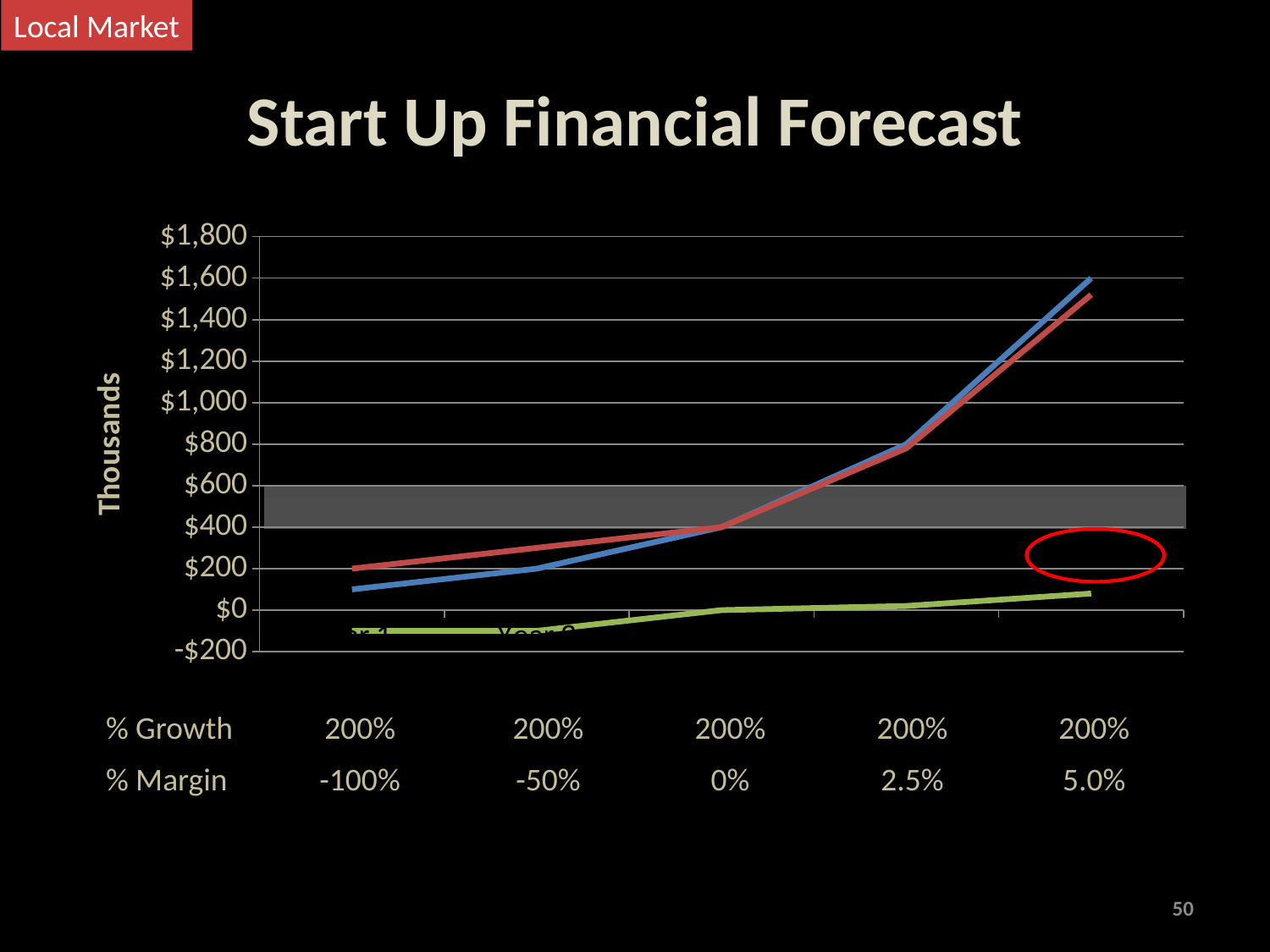
What is the title of the chart? Start Up Financial Forecast What is the highest value shown on the vertical axis? $1,800 In the table below the chart, what is the % Margin value in the last (fifth) column? 5.0% Is the final (rightmost) value of the blue line greater or less than $1,400? greater Is the first (leftmost) value of the green line greater or less than $0? less What kind of chart is shown on the slide? line chart Does the blue line rise or fall from left to right? rise Is the final (rightmost) value of the green line greater or less than $200? less At the leftmost point, which line is higher, the red line or the blue line? red line What is the title of the vertical axis? Thousands What is the lowest value shown on the vertical axis? -$200 How many data points does each line in the chart have? 5